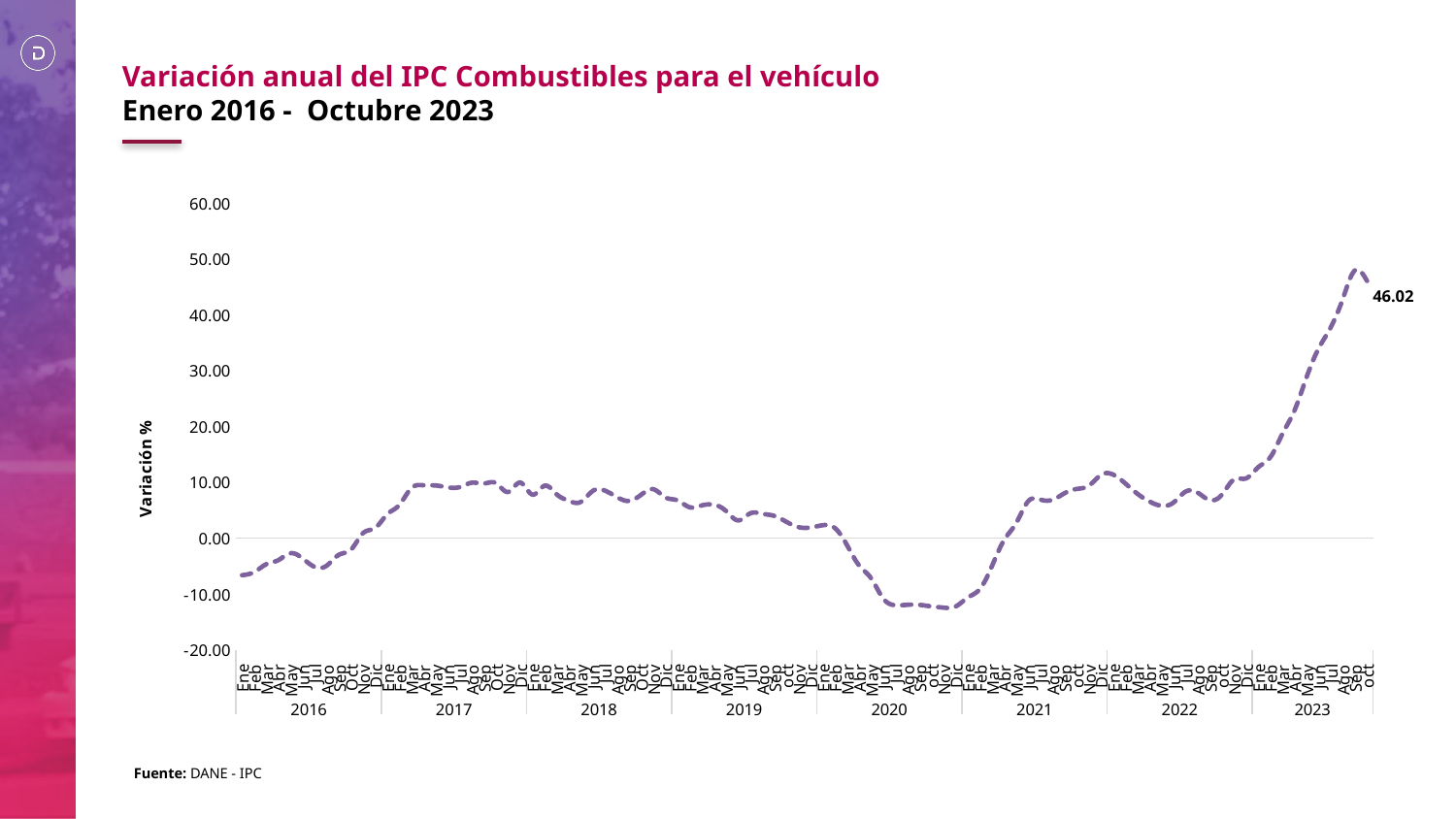
In which year does the line reach its highest value? 2023 Does the line rise or fall from Ene 2020 to Jun 2020? fall In which year does the line reach its lowest value? 2020 Is the value for Ene 2016 greater or less than 0.00? less Is the value for Sep 2020 greater or less than 0.00? less What source is cited below the chart? DANE - IPC What is the title of the chart? Variación anual del IPC Combustibles para el vehículo Is the value for Ene 2023 greater or less than 10.00? greater Does the line rise or fall from Ene 2023 to Oct 2023? rise What kind of chart is shown on the slide? line chart Which is larger, the value for Oct 2023 or the value for Ene 2016? Oct 2023 What is the value labelled at the last point of the line (Oct 2023)? 46.02